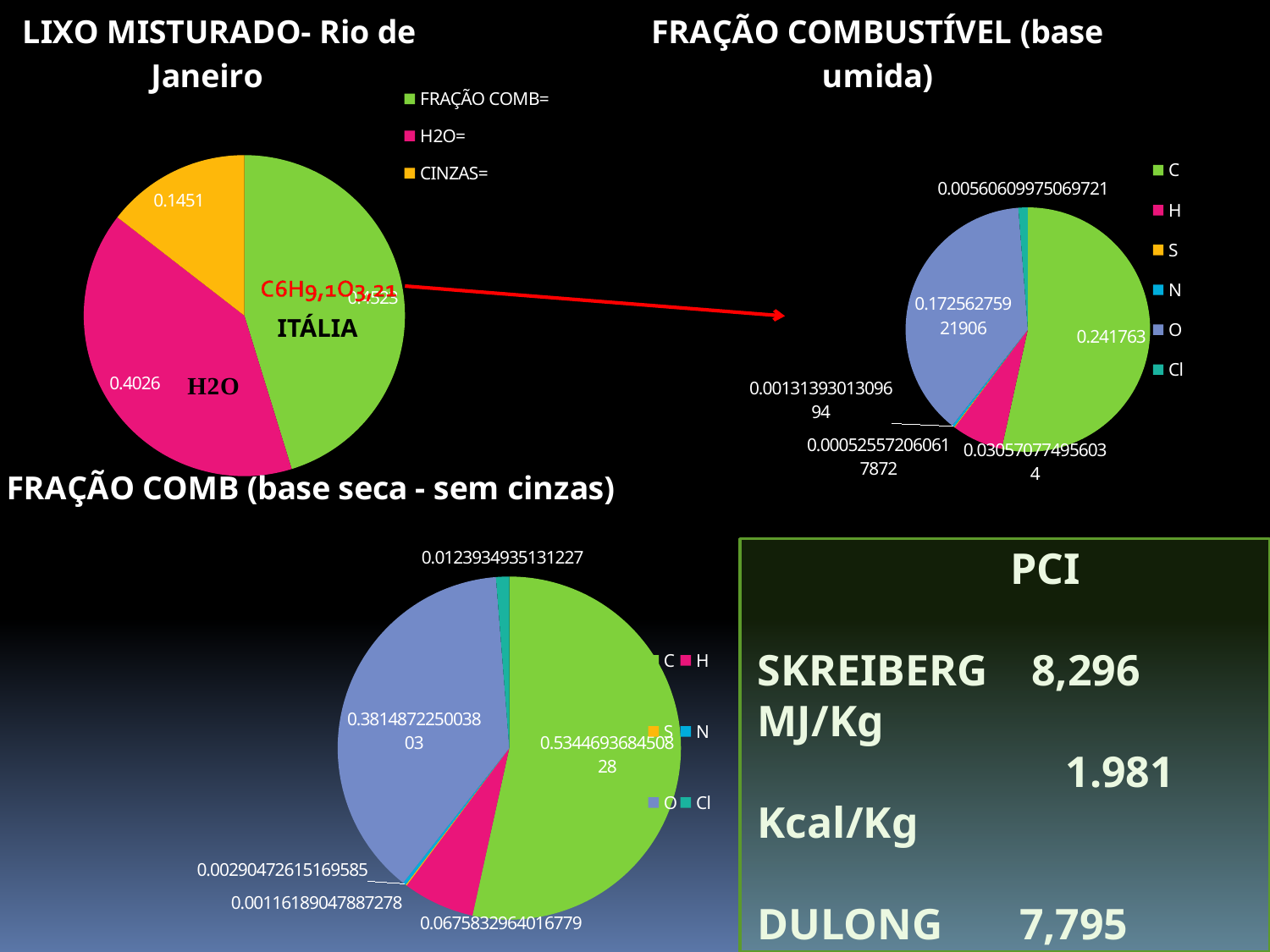
In the 'FRAÇÃO COMBUSTÍVEL (base umida)' chart, what is the value for Cl? 0.00560609975069721 In the 'LIXO MISTURADO- Rio de Janeiro' chart, what is the value for H2O? 0.4026 In the 'FRAÇÃO COMBUSTÍVEL (base umida)' chart, which is larger, the slice for C or the slice for O? C How many entries does the legend of the 'FRAÇÃO COMBUSTÍVEL (base umida)' chart list? 6 In the 'FRAÇÃO COMB (base seca - sem cinzas)' chart, which element has the largest slice? C In the 'LIXO MISTURADO- Rio de Janeiro' chart, which category has the smallest slice? CINZAS In the 'LIXO MISTURADO- Rio de Janeiro' chart, what is the value for CINZAS? 0.1451 In the 'FRAÇÃO COMB (base seca - sem cinzas)' chart, what is the value for H? 0.0675832964016779 What kind of chart is the 'LIXO MISTURADO- Rio de Janeiro' chart? pie chart In the 'FRAÇÃO COMBUSTÍVEL (base umida)' chart, what is the value for C? 0.241763 In the 'LIXO MISTURADO- Rio de Janeiro' chart, which category has the largest slice? FRAÇÃO COMB How many entries does the legend of the 'LIXO MISTURADO- Rio de Janeiro' chart list? 3